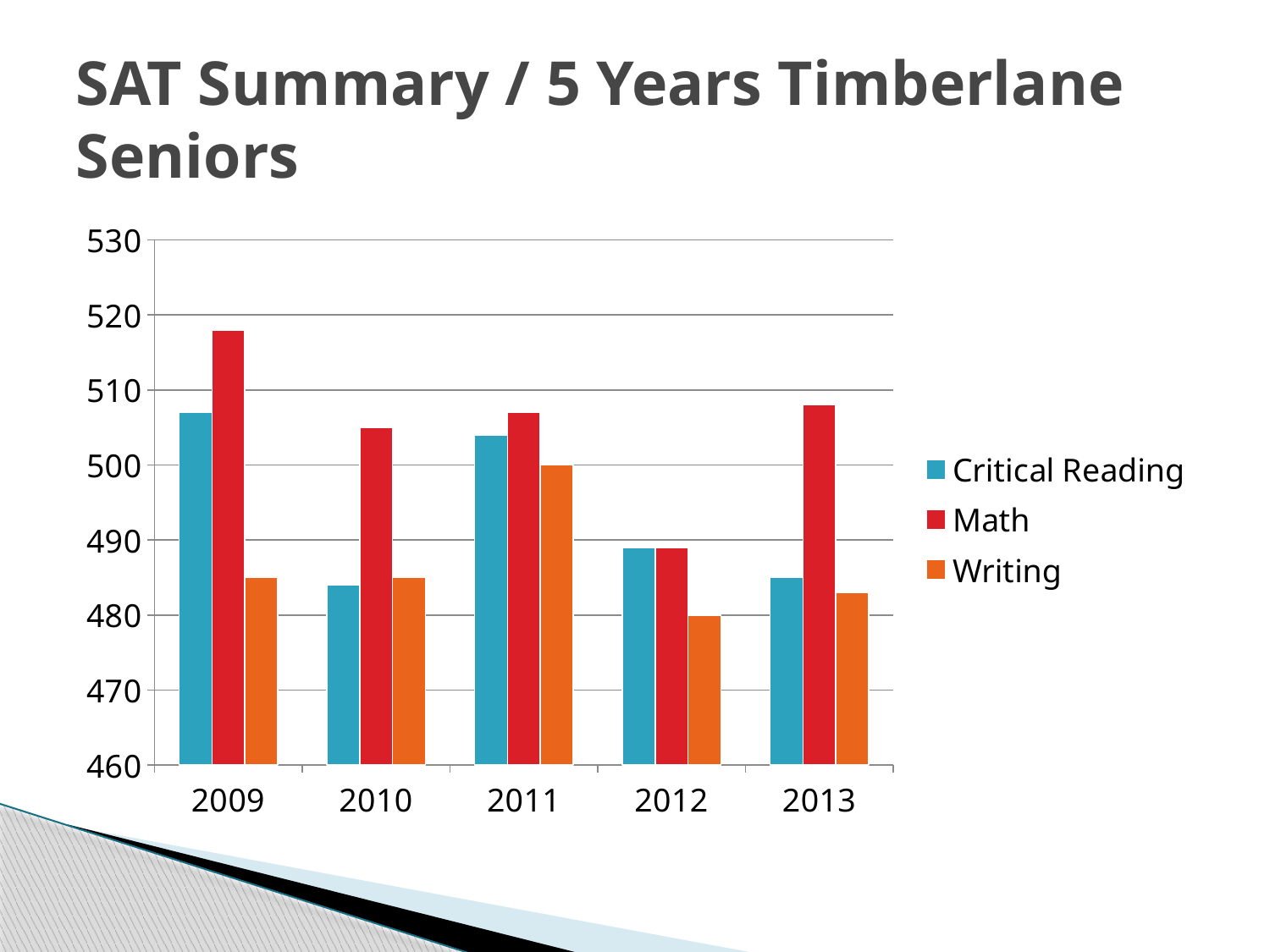
How many years are shown on the x axis? 5 Is the Writing value for 2013 greater or less than 490? less In which year is the Writing score lowest? 2012 What kind of chart is shown on the slide? Bar chart Is the Math value for 2009 greater or less than 510? greater Is the Critical Reading value for 2010 greater or less than 490? less In 2009, which is larger, the Math score or the Critical Reading score? Math Which colour represents Writing in the legend? Orange In which year is the Math score highest? 2009 How many series does the legend list? 3 Does the Math score rise or fall from 2009 to 2012? Fall